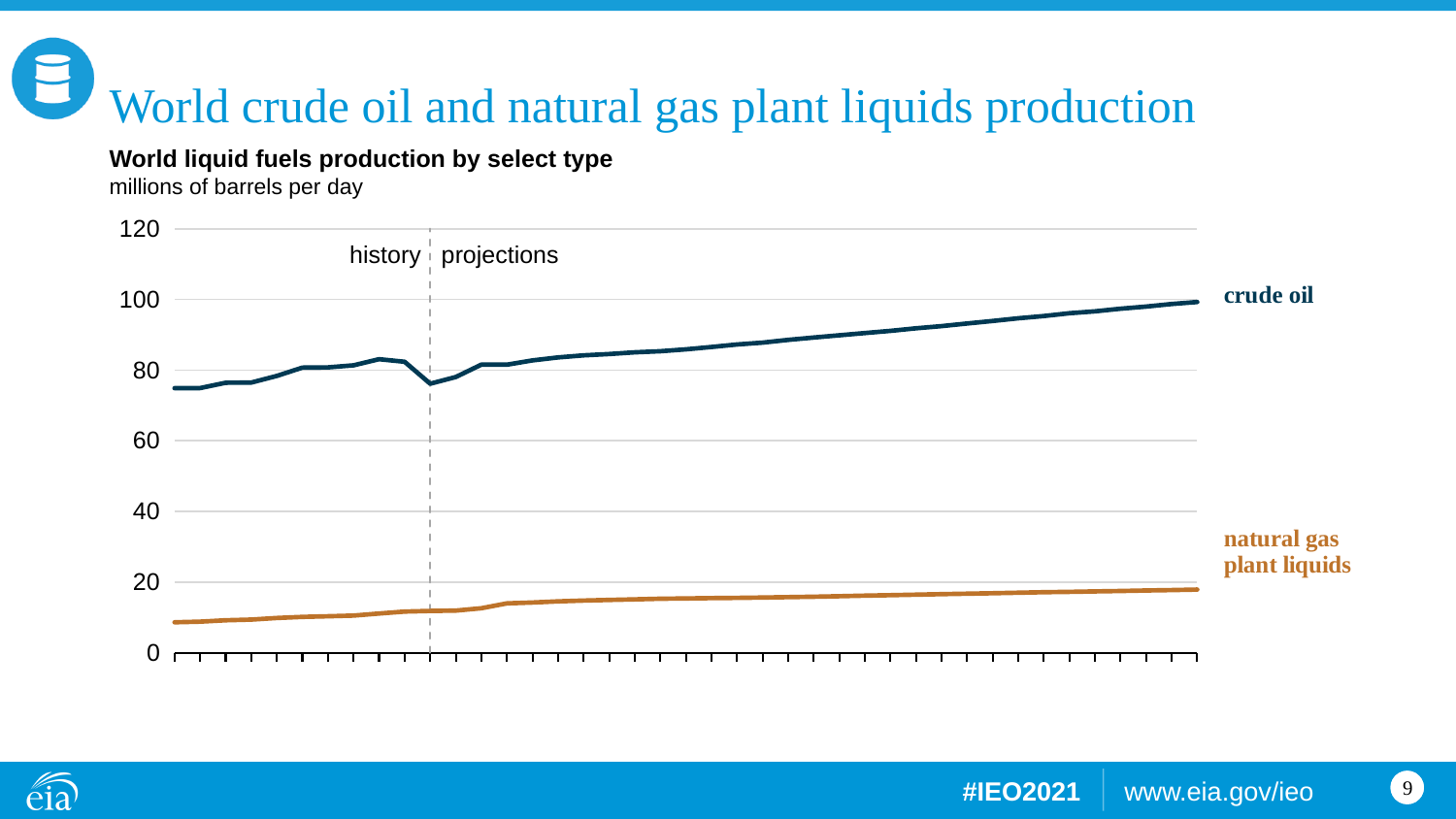
What kind of chart is shown on the slide? line chart Is the value for natural gas plant liquids at the right end of the chart greater or less than 20? less Is the value for crude oil at the left end of the chart greater or less than 60? greater Does the natural gas plant liquids line generally rise or fall from left to right? rise What is the highest value shown on the y axis? 120 Which series has the higher values throughout the chart, crude oil or natural gas plant liquids? crude oil How many series are plotted on the chart? 2 What unit is the chart's y axis measured in? millions of barrels per day Does the crude oil line generally rise or fall across the projections period? rise What is the title of the chart? World liquid fuels production by select type Is the value for natural gas plant liquids at the left end of the chart greater or less than 20? less